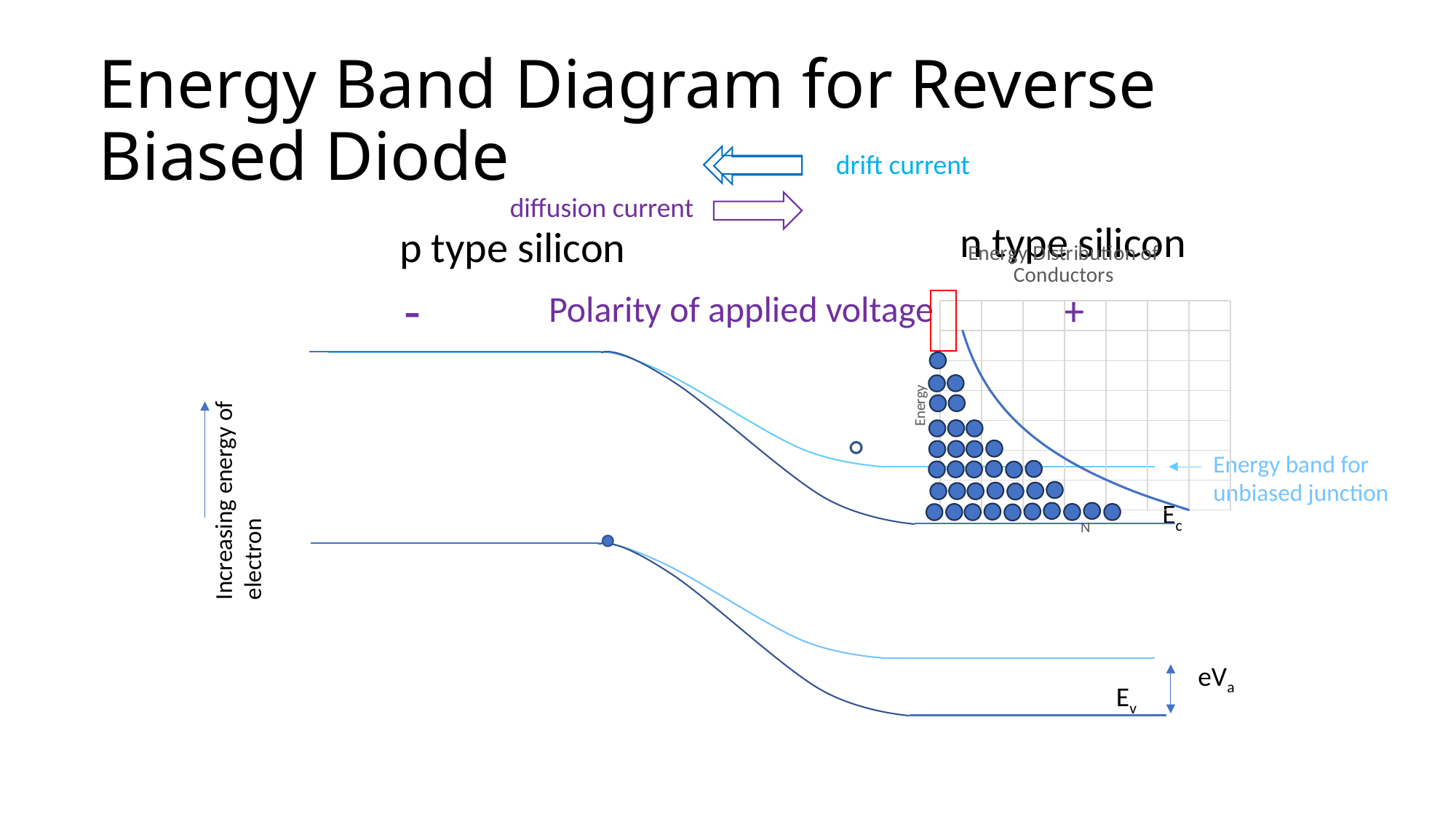
What kind of chart is the small 'Energy Distribution of Conductors' chart? line chart What is the title of the small chart embedded on the right side of the slide? Energy Distribution of Conductors What is the label on the vertical axis of the 'Energy Distribution of Conductors' chart? Energy In the 'Energy Distribution of Conductors' chart, does the plotted curve rise or fall as you move along the x axis? fall